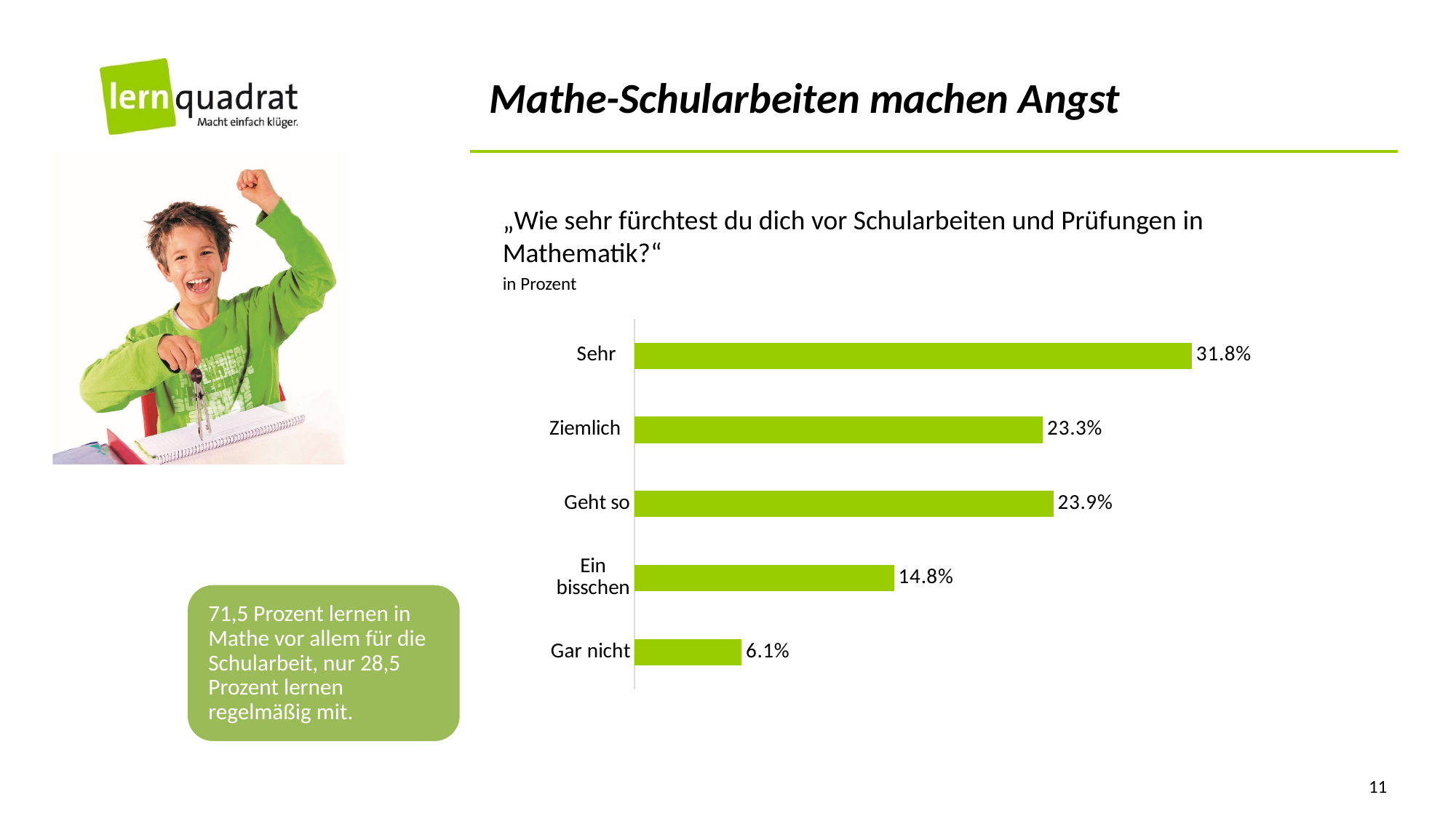
What is the value for "Geht so"? 23.9% What is the value for "Ein bisschen"? 14.8% What is the value for "Sehr"? 31.8% Which category has the highest value? Sehr Which category has the lowest value? Gar nicht What is the value for "Gar nicht"? 6.1% What is the difference between the values for "Geht so" and "Ziemlich"? 0.6% What is the difference between the values for "Sehr" and "Gar nicht"? 25.7% What kind of chart is shown on the slide? Bar chart Which is larger, the value for "Ziemlich" or the value for "Ein bisschen"? Ziemlich What is the value for "Ziemlich"? 23.3% How many categories does the chart show? 5